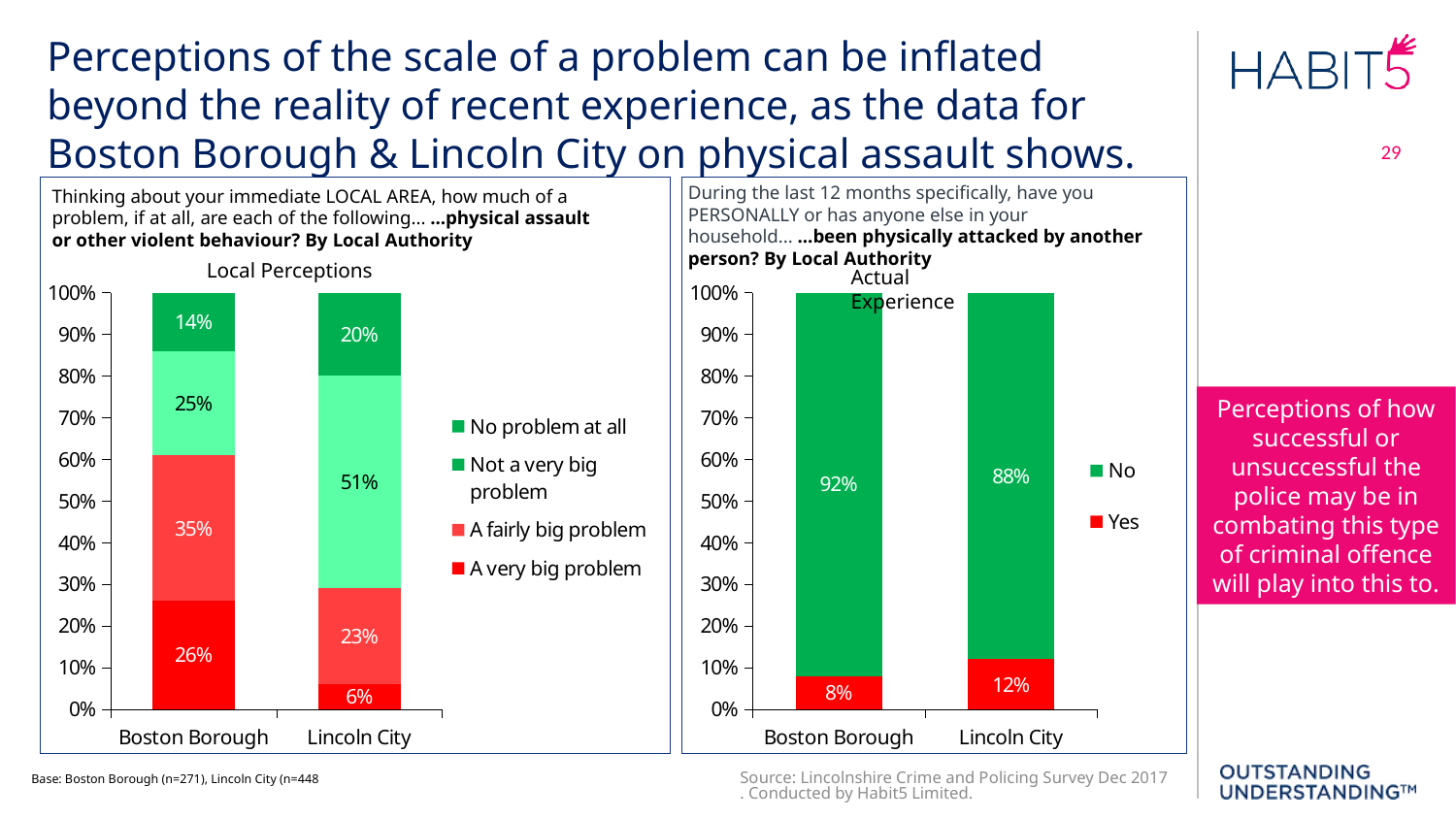
In the Actual Experience chart, what percentage of Lincoln City respondents said Yes to having been physically attacked? 12% In the Local Perceptions chart, what is the difference between the 'A fairly big problem' shares for Boston Borough and Lincoln City? 12% In the Local Perceptions chart, what percentage of Lincoln City respondents said physical assault is no problem at all? 20% In the Actual Experience chart, what is the difference between the Yes shares for Lincoln City and Boston Borough? 4% In the Local Perceptions chart, what is the combined share of Boston Borough respondents who said physical assault is a very big or a fairly big problem? 61% In the Local Perceptions chart, which local authority has the larger share saying physical assault is a very big problem, Boston Borough or Lincoln City? Boston Borough In the Local Perceptions chart, what percentage of Lincoln City respondents said physical assault is not a very big problem? 51% How many series does the legend of the Local Perceptions chart list? 4 In the Actual Experience chart, what percentage of Boston Borough respondents said No? 92% How many local authorities are shown on the x axis of the Actual Experience chart? 2 In the Local Perceptions chart, what percentage of Boston Borough respondents said physical assault is a very big problem? 26% What type of chart is the Actual Experience chart? Stacked bar chart